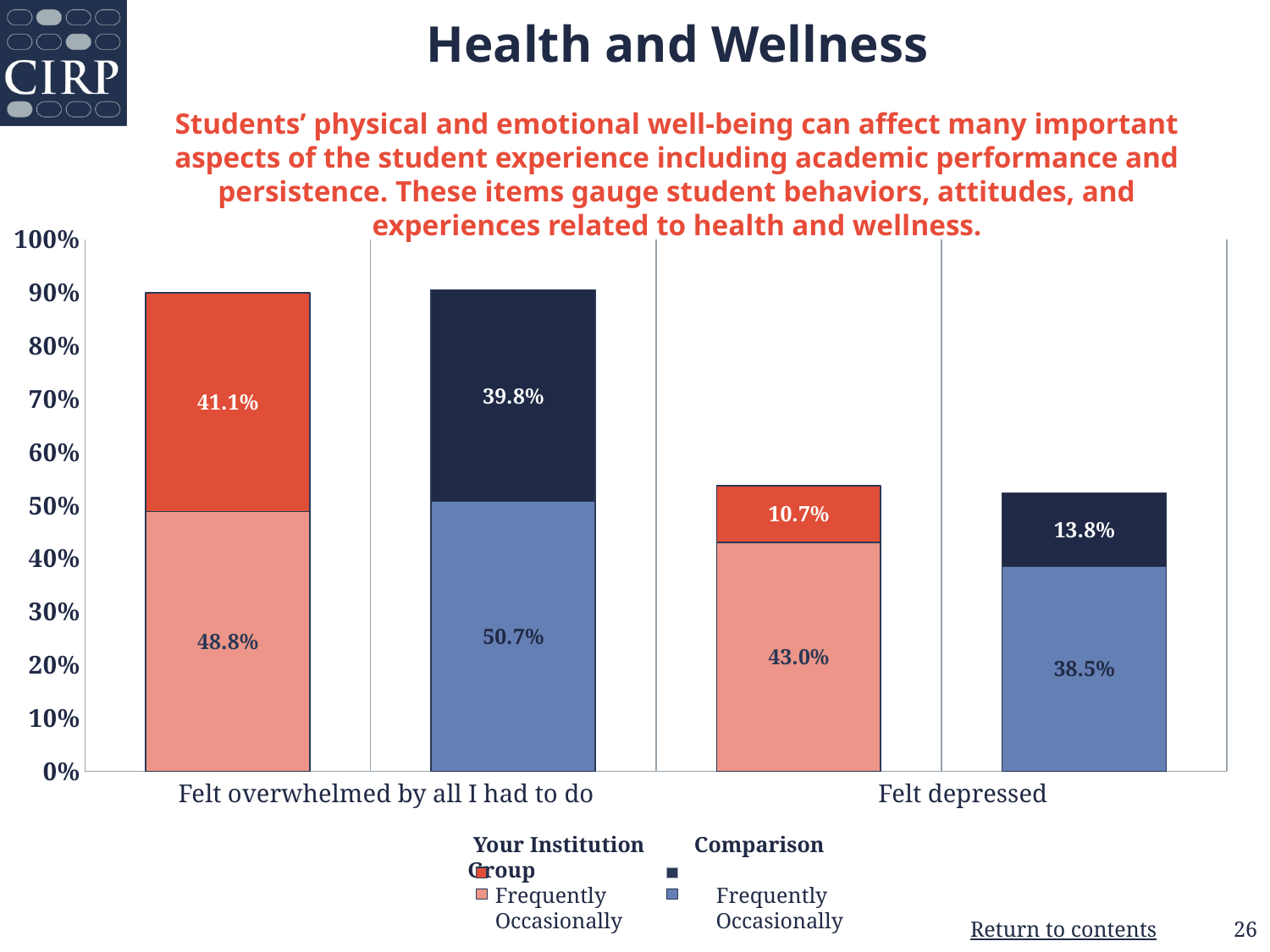
What is the total percentage (Frequently plus Occasionally) for the Comparison Group on 'Felt depressed'? 52.3% What is the total percentage (Frequently plus Occasionally) for Your Institution on 'Felt overwhelmed by all I had to do'? 89.9% For 'Felt overwhelmed by all I had to do', which is larger: the 'Occasionally' value for Your Institution or for the Comparison Group? Comparison Group How many series does the legend list? 4 Which 'Frequently' segment has the lowest value on the chart? Your Institution, Felt depressed (10.7%) What percentage of students in the Comparison Group reported occasionally feeling depressed? 38.5% What type of chart is shown on the slide? Stacked bar chart What is the difference between the Comparison Group's and Your Institution's 'Frequently' values for 'Felt depressed'? 3.1% What percentage of students at Your Institution reported frequently feeling depressed? 10.7% Is the total stacked bar for Your Institution on 'Felt depressed' greater or less than 50%? greater What percentage of students in the Comparison Group reported occasionally feeling overwhelmed by all they had to do? 50.7% What percentage of students at Your Institution reported frequently feeling overwhelmed by all they had to do? 41.1%